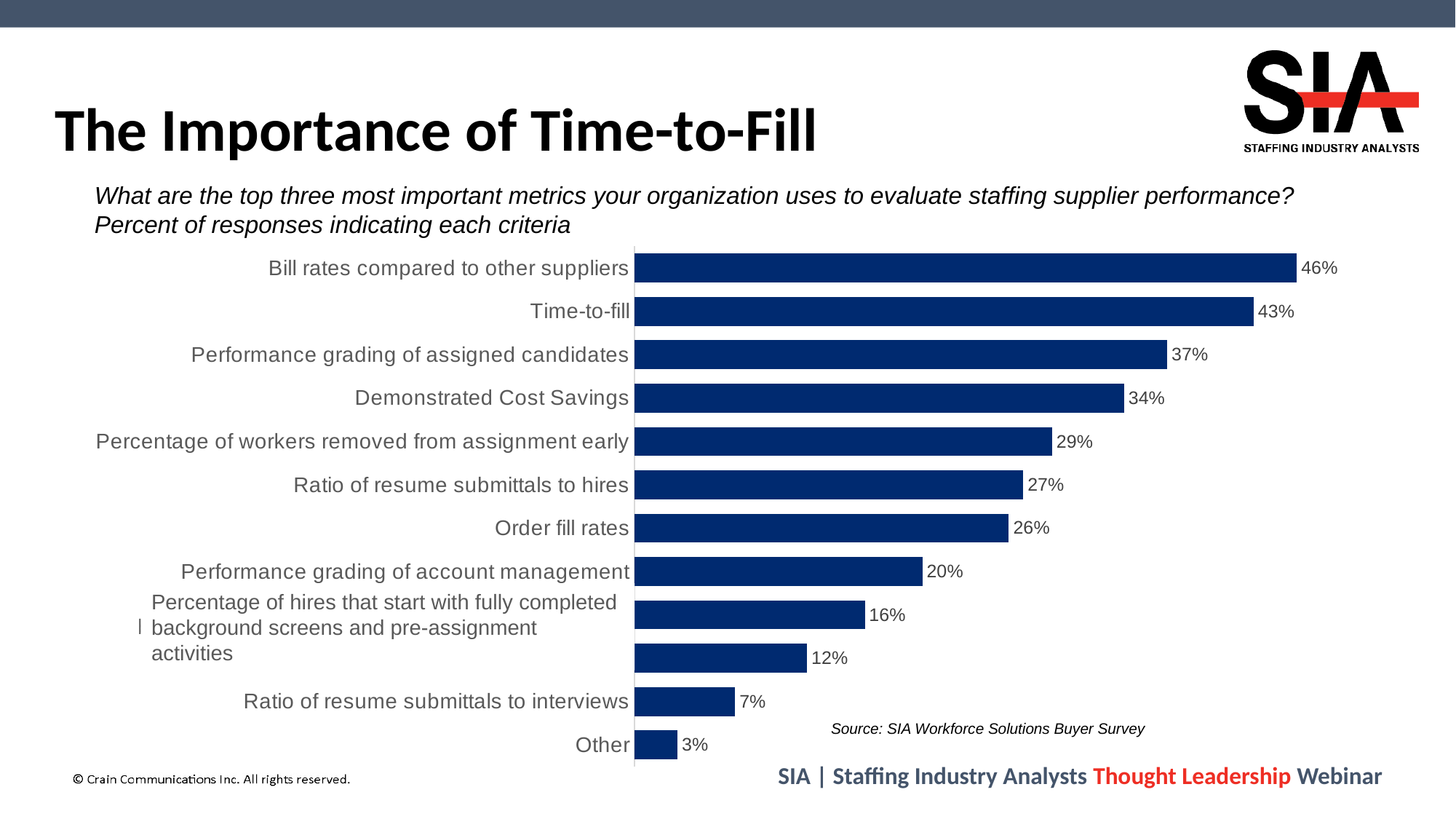
What is the difference between Performance grading of assigned candidates and Performance grading of account management? 17% Which category has the lowest percentage of responses? Other How many bars are plotted in the chart? 12 Which has a higher value: Percentage of workers removed from assignment early or Order fill rates? Percentage of workers removed from assignment early Which metric has the highest percentage of responses? Bill rates compared to other suppliers Which is larger: Ratio of resume submittals to hires or Ratio of resume submittals to interviews? Ratio of resume submittals to hires What is the difference between Bill rates compared to other suppliers and Time-to-fill? 3% What is the source cited for the chart data? SIA Workforce Solutions Buyer Survey What is the value for Order fill rates? 26% What percentage of responses indicated Time-to-fill as a top three metric? 43% What is the value for Demonstrated Cost Savings? 34% What type of chart is shown on the slide? Bar chart